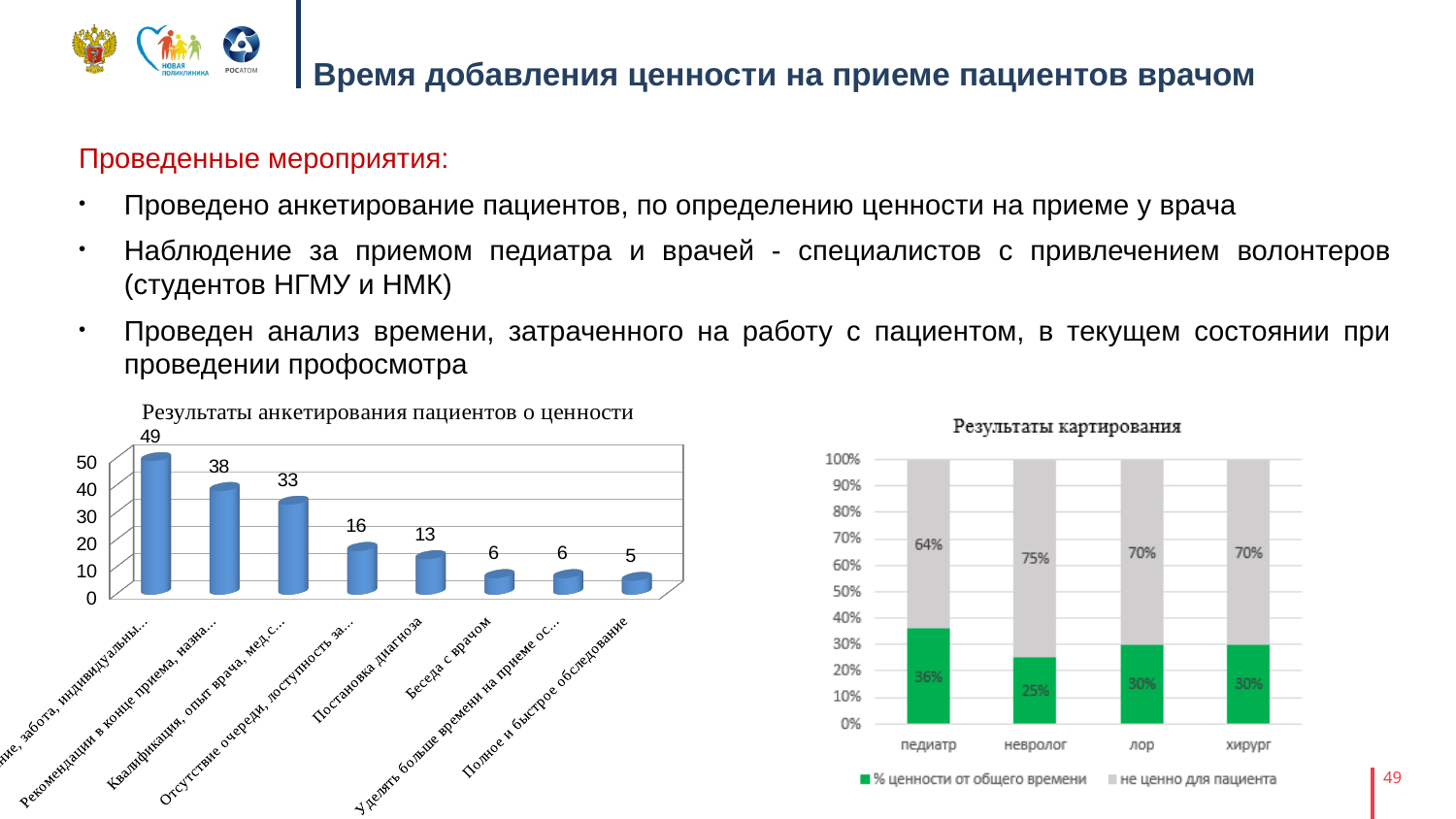
In the chart 'Результаты анкетирования пациентов о ценности', what is the highest value shown? 49 In the chart 'Результаты анкетирования пациентов о ценности', what is the difference between the value for 'Постановка диагноза' and the value for 'Беседа с врачом'? 7 In the chart 'Результаты анкетирования пациентов о ценности', what is the value for 'Беседа с врачом'? 6 In the chart 'Результаты анкетирования пациентов о ценности', how many bars are plotted? 8 In the chart 'Результаты картирования', how many series does the legend list? 2 In the chart 'Результаты анкетирования пациентов о ценности', which category has the lowest value? Полное и быстрое обследование What kind of chart is 'Результаты картирования'? Stacked bar chart In the chart 'Результаты анкетирования пациентов о ценности', what is the value for 'Постановка диагноза'? 13 In the chart 'Результаты анкетирования пациентов о ценности', what is the value for 'Полное и быстрое обследование'? 5 In the chart 'Результаты картирования', which category has the lowest '% ценности от общего времени'? невролог In the chart 'Результаты картирования', what is the '% ценности от общего времени' value for 'педиатр'? 36% In the chart 'Результаты картирования', what is the 'не ценно для пациента' value for 'невролог'? 75%